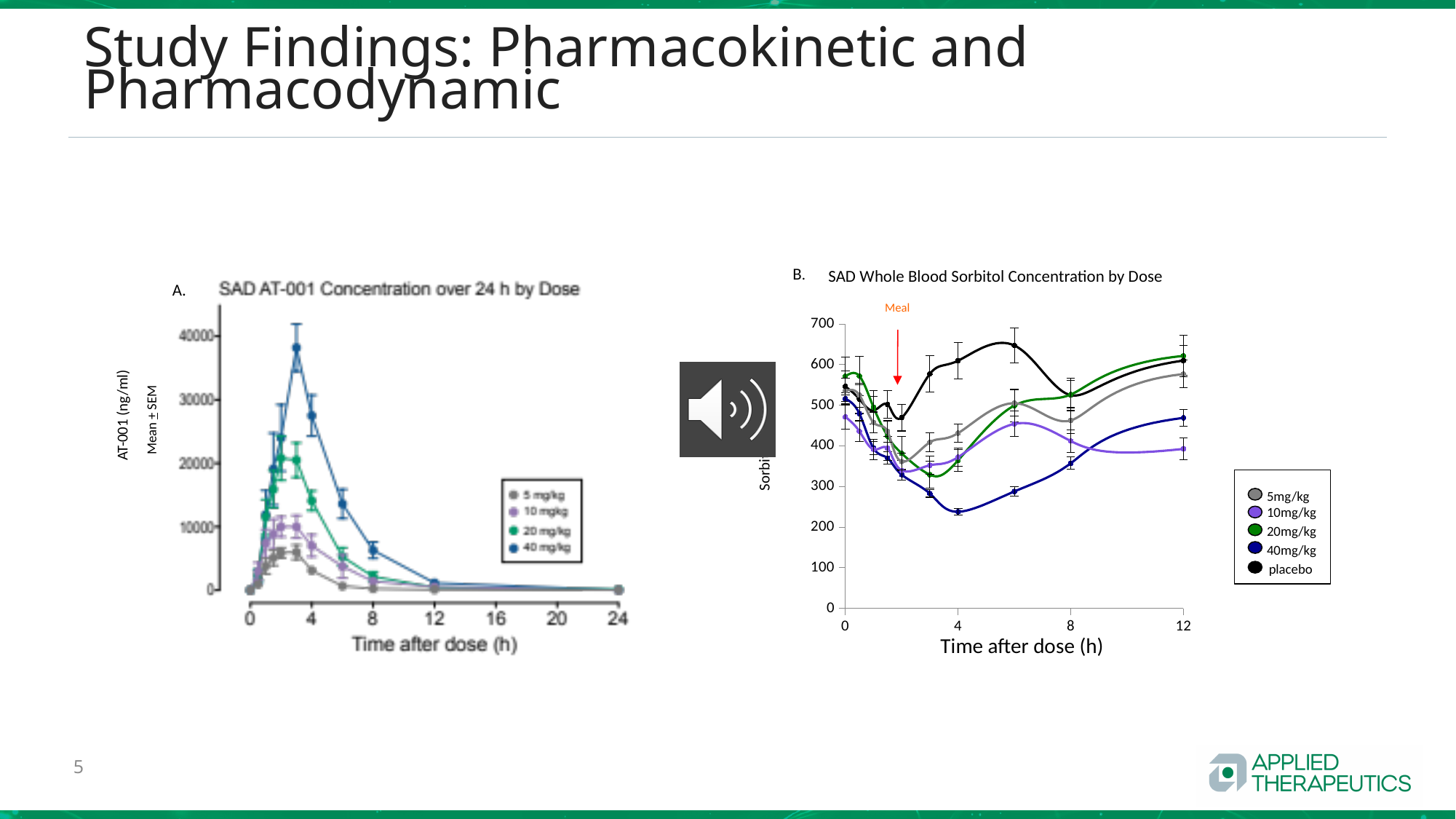
In chart B, is the value for 40mg/kg at 4 h greater or less than 300? less What kind of chart is chart A, 'SAD AT-001 Concentration over 24 h by Dose'? line chart In chart A, is the peak value for 20 mg/kg greater or less than 30000? less In chart A, which dose has the lowest peak concentration? 5 mg/kg In chart B, which series has the lowest value at 4 h after dose? 40mg/kg How many series does the legend of chart A list? 4 In chart B, which series has the highest value at 6 h after dose? placebo In chart B, what event does the red arrow annotation mark? Meal In chart A, is the peak value for 40 mg/kg greater or less than 30000? greater How many series does the legend of chart B, 'SAD Whole Blood Sorbitol Concentration by Dose', list? 5 In chart A, do the concentrations rise or fall between 4 h and 24 h after dose? fall In chart A, which dose reaches the highest peak concentration? 40 mg/kg